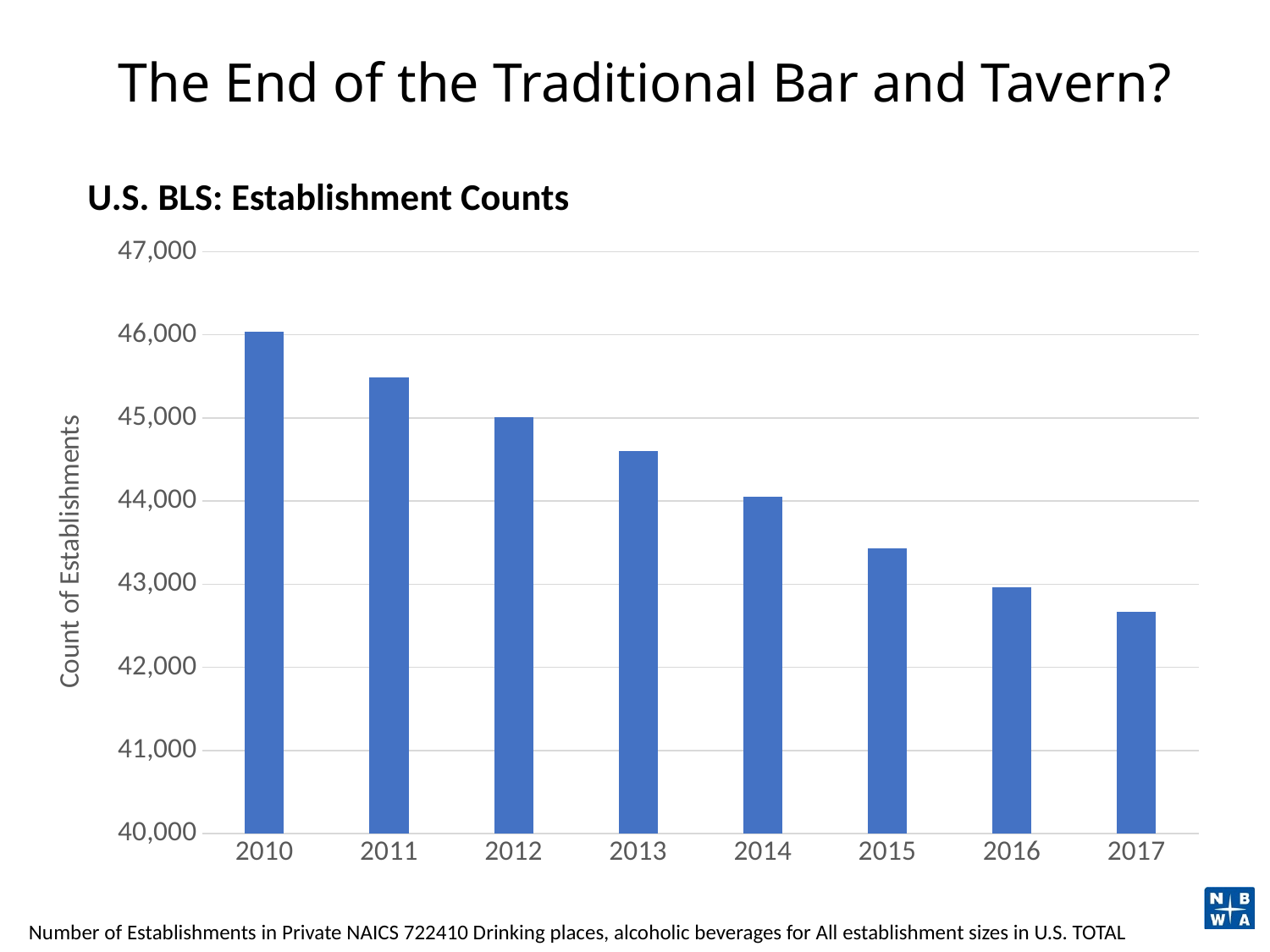
Is the value for 2017 greater or less than 43,000? less Which year has the highest count of establishments? 2010 What kind of chart is shown on the slide? bar chart Which year has the lowest count of establishments? 2017 Is the value for 2015 greater or less than 44,000? less Is the value for 2013 greater or less than 44,000? greater What is the title of the chart? U.S. BLS: Establishment Counts What is the label on the y axis of the chart? Count of Establishments How many years are shown on the x axis of the chart? 8 Do the establishment counts rise or fall from 2010 to 2017? fall Which year has a larger count of establishments, 2011 or 2016? 2011